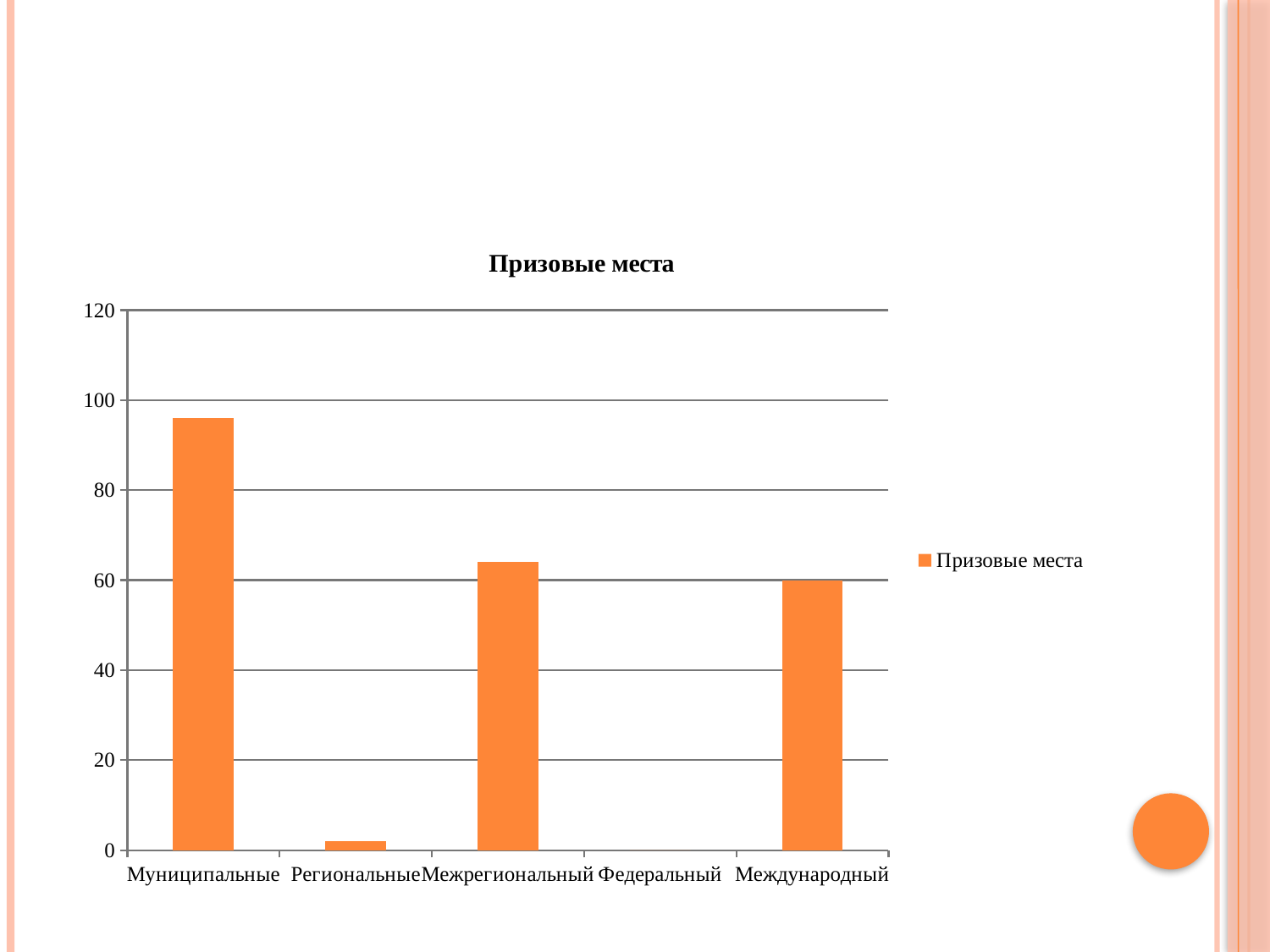
How many categories are shown on the x axis of the chart? 5 Is the value for Межрегиональный greater or less than 60? greater Which category has the highest value? Муниципальные What kind of chart is shown on the slide? bar chart Which is larger, the value for Региональные or the value for Межрегиональный? Межрегиональный Which category has the lowest value? Федеральный What is the value for Международный? 60 Which is larger, the value for Муниципальные or the value for Международный? Муниципальные Is the value for Региональные greater or less than 20? less How many series does the legend list? 1 Is the value for Муниципальные greater or less than 80? greater What is the title of the chart? Призовые места